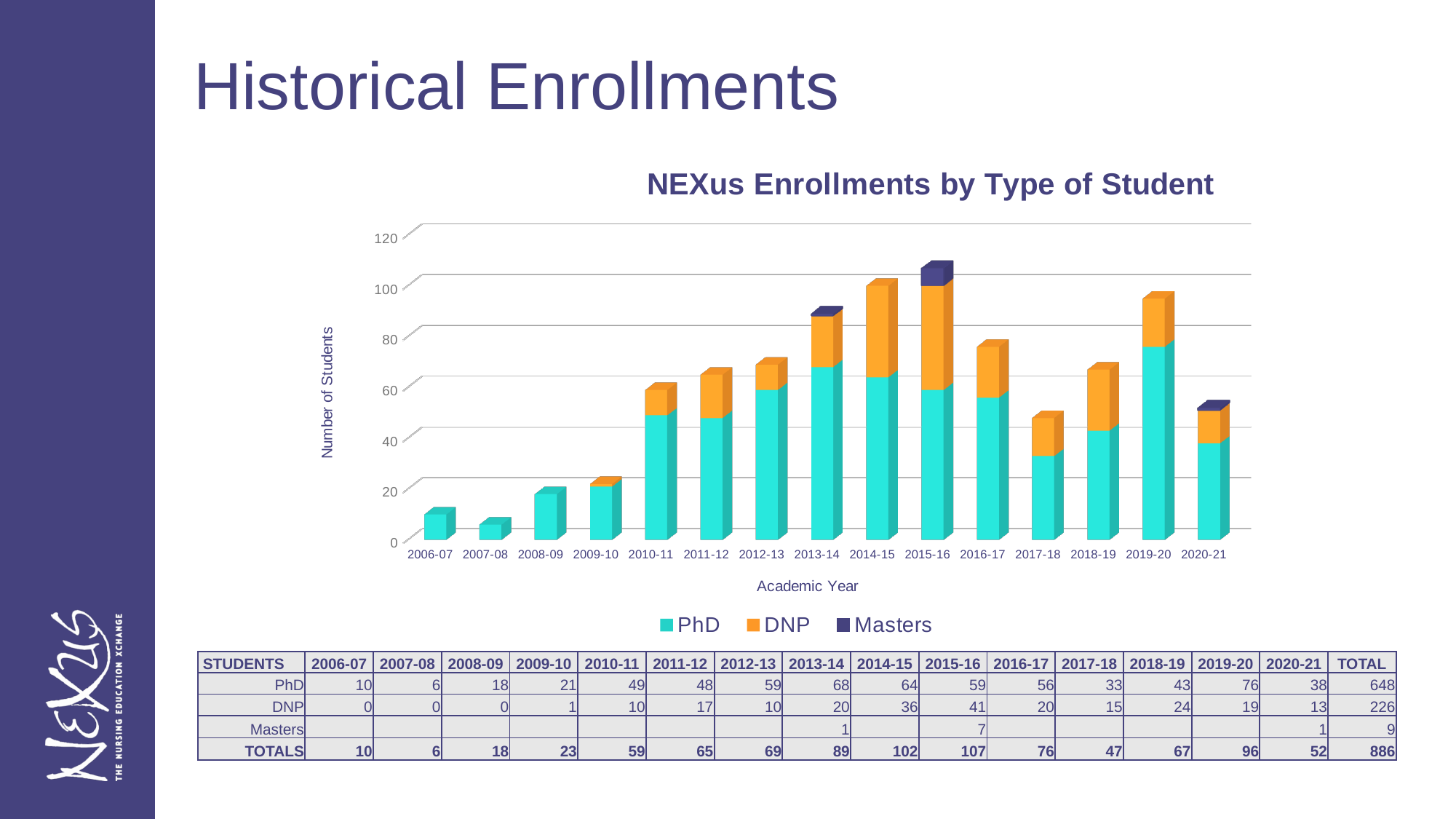
Which is larger, the DNP enrollment for 2014-15 or for 2018-19? 2014-15 What is the DNP enrollment for 2015-16? 41 Which academic year has the highest total enrollment? 2015-16 What is the PhD enrollment for 2019-20? 76 Which academic year has the lowest total enrollment? 2007-08 How many series does the legend list? 3 What kind of chart is shown on the slide? stacked bar chart What is the difference between the PhD enrollments for 2013-14 and 2017-18? 35 How many academic years are plotted on the x axis? 15 What is the title of the chart? NEXus Enrollments by Type of Student What is the total enrollment for the 2014-15 stacked bar? 102 What is the Masters enrollment for 2013-14? 1